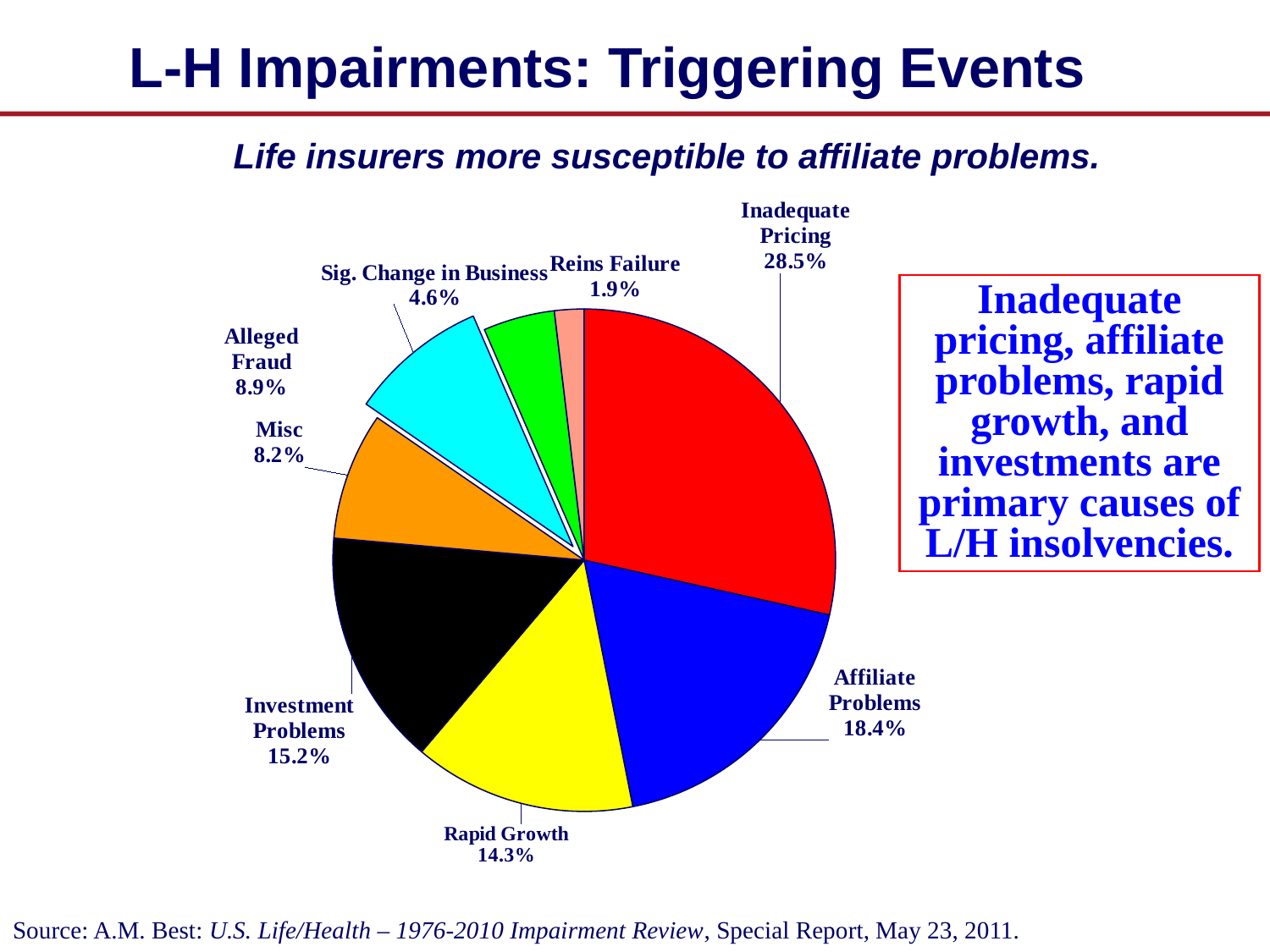
Which triggering event has the smallest slice of the pie? Reins Failure What kind of chart is shown on the slide? Pie chart Which is larger, the share for Alleged Fraud or the share for Misc? Alleged Fraud What share of L-H impairments is attributed to Inadequate Pricing? 28.5% Which triggering event has the largest slice of the pie? Inadequate Pricing What percentage of the pie is Affiliate Problems? 18.4% How many slices does the pie chart have? 8 What colour is the Rapid Growth slice? Yellow What is the difference in percentage points between Inadequate Pricing and Affiliate Problems? 10.1 Which is larger, Investment Problems or Rapid Growth? Investment Problems What is the value shown for Investment Problems? 15.2% What share does Reins Failure account for? 1.9%